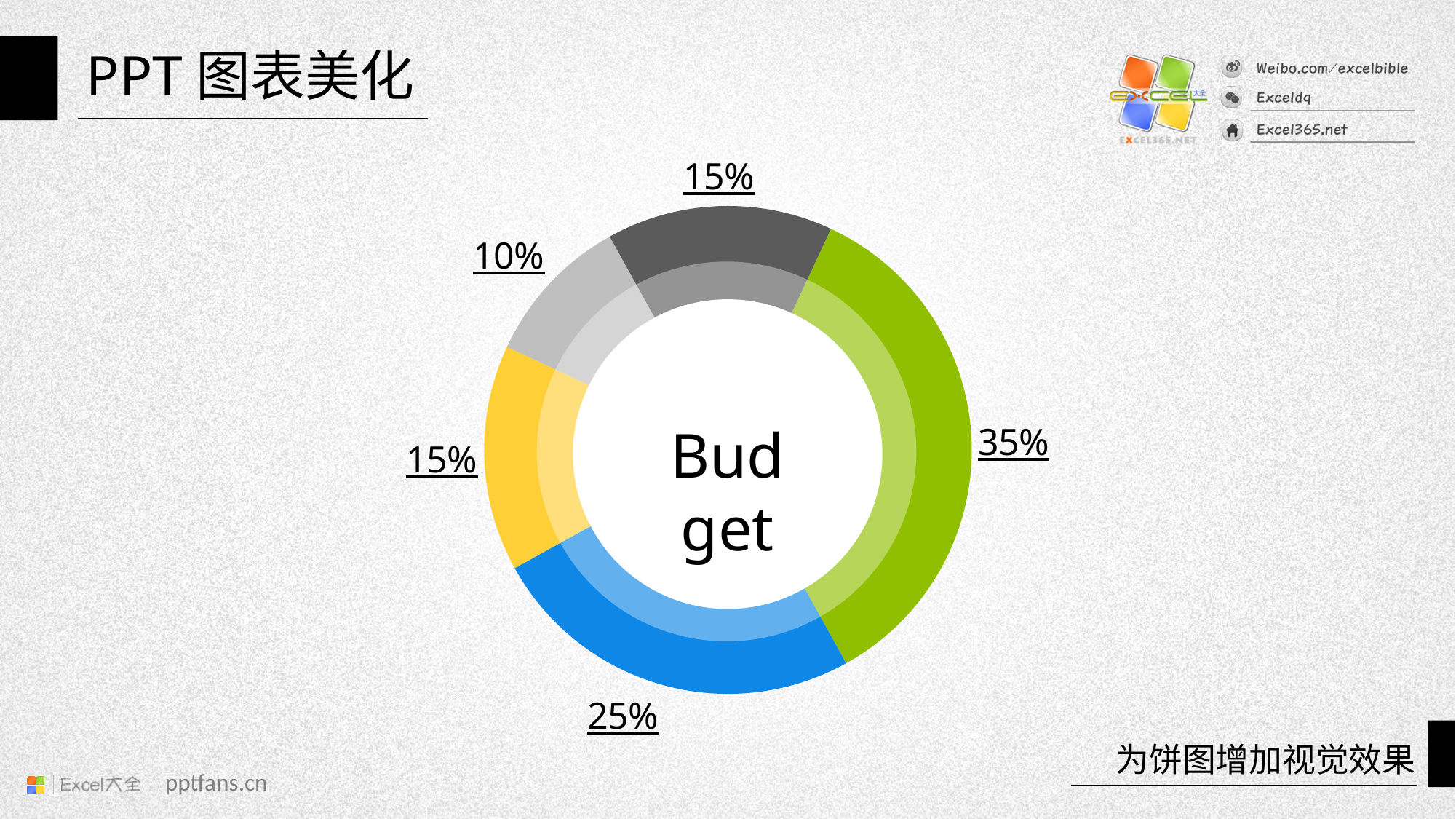
Which slice has the smallest share of the donut chart? The light gray slice (10%) Which slice has the largest share of the donut chart? The green slice (35%) What percentage is shown for the blue slice? 25% Which is larger, the blue slice or the yellow slice? The blue slice What percentage is shown for the light gray slice? 10% What kind of chart is shown on the slide? Donut chart What percentage is shown for the yellow slice? 15% What is the difference in percentage points between the green slice and the blue slice? 10 percentage points What percentage is shown for the dark gray slice? 15% What percentage is shown for the green slice? 35% What text appears in the centre of the donut chart? Budget How many slices does the donut chart have? 5